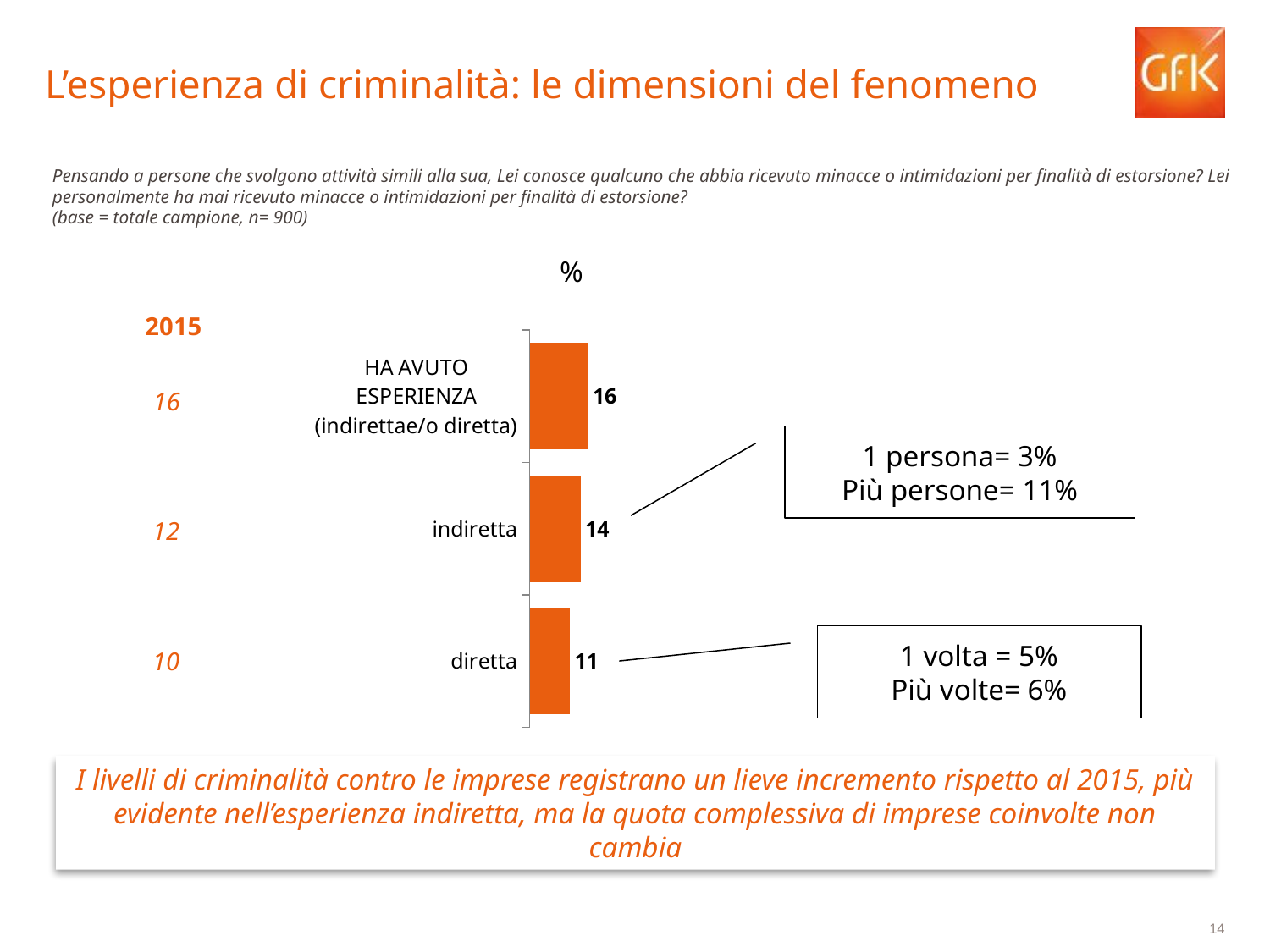
What is the value for "indiretta" in the bar chart? 14 What is the value for "HA AVUTO ESPERIENZA (indiretta e/o diretta)" in the bar chart? 16 What kind of chart is shown on the slide? bar chart What is the value for "diretta" in the bar chart? 11 Which is larger, the value for "indiretta" or the value for "diretta"? indiretta Which category has the highest value in the bar chart? HA AVUTO ESPERIENZA (indiretta e/o diretta) How many categories are shown in the bar chart? 3 Which category has the lowest value in the bar chart? diretta What is the difference between the values for "indiretta" and "diretta"? 3 What is the title shown above the bar chart? % What colour are the bars in the chart? orange What is the difference between the values for "HA AVUTO ESPERIENZA (indiretta e/o diretta)" and "indiretta"? 2